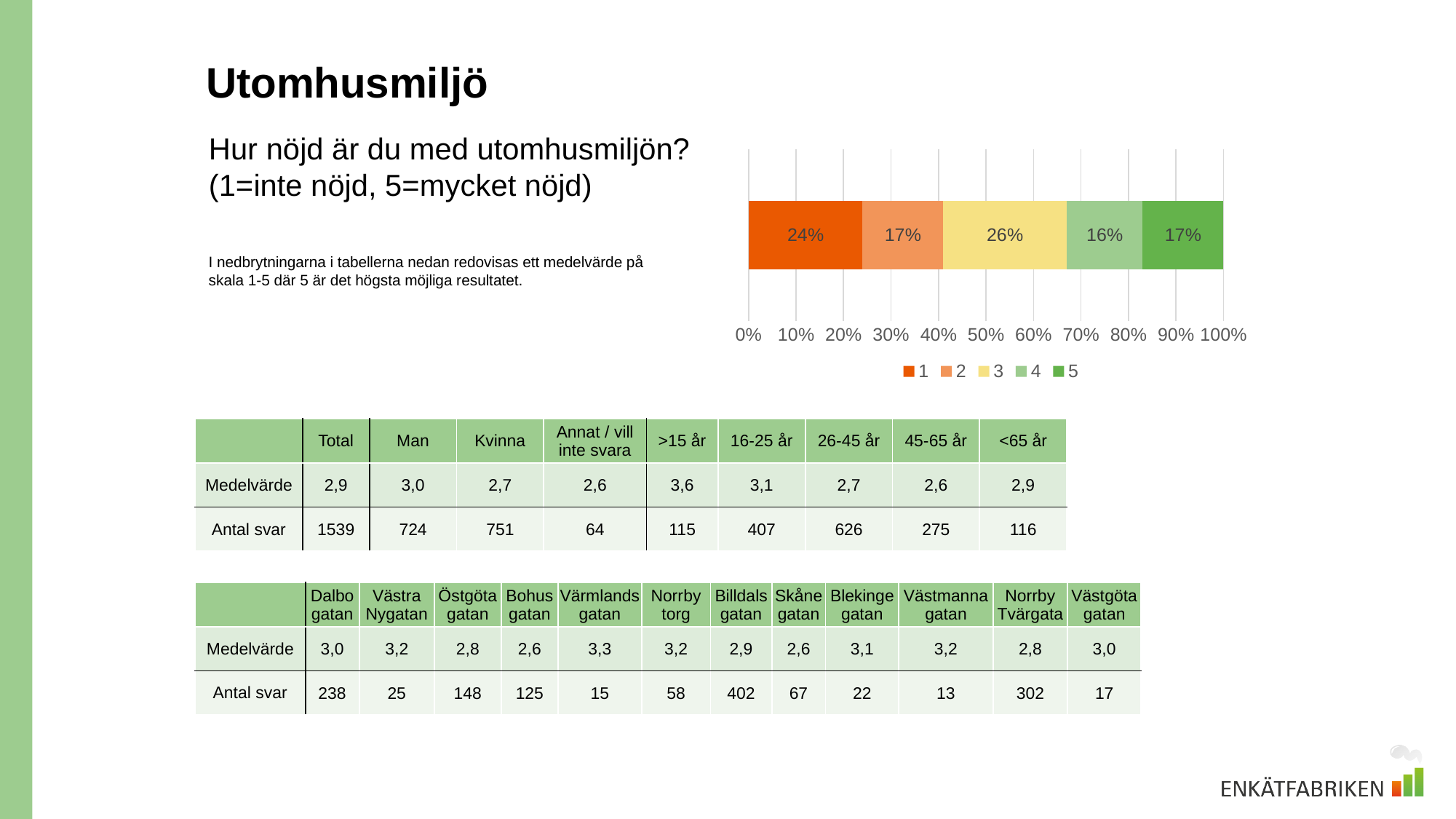
What is the highest value shown on the x axis of the chart? 100% Which rating has the smallest share in the bar? 4 What percentage of respondents gave a rating of 3? 26% What kind of chart is shown on the slide? Stacked bar chart What percentage of respondents gave a rating of 5? 17% What is the total of all segments in the stacked bar? 100% Which is larger, the share for rating 1 or the share for rating 3? 3 What is the difference between the share for rating 1 and the share for rating 2? 7% Which rating has the largest share in the bar? 3 How many series does the legend list? 5 What is the difference in percentage points between the share for rating 3 and the share for rating 4? 10% What percentage of respondents gave a rating of 1? 24%